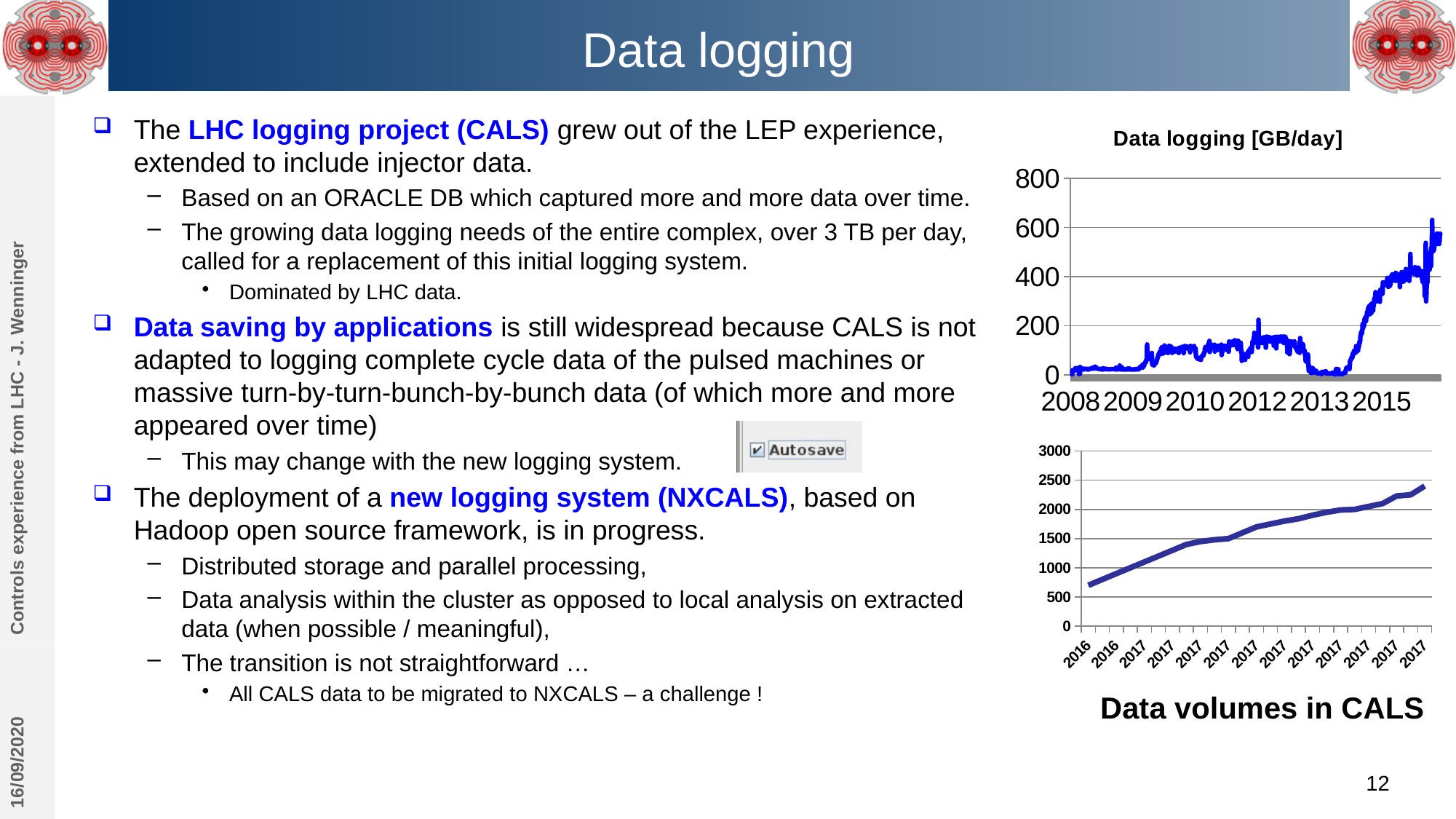
In the 'Data logging [GB/day]' chart, is the value around 2010 greater or less than 400? less In the 'Data logging [GB/day]' chart, is the value at the end of the series (2015) greater or less than 400? greater What kind of chart is the 'Data volumes in CALS' chart? line chart What kind of chart is the 'Data logging [GB/day]' chart? line chart In the 'Data volumes in CALS' chart, is the last plotted value greater or less than 2000? greater What is the title of the upper chart on the slide? Data logging [GB/day] In the 'Data volumes in CALS' chart, do the values rise or fall from left to right along the x axis? rise What is the highest value shown on the y axis of the 'Data logging [GB/day]' chart? 800